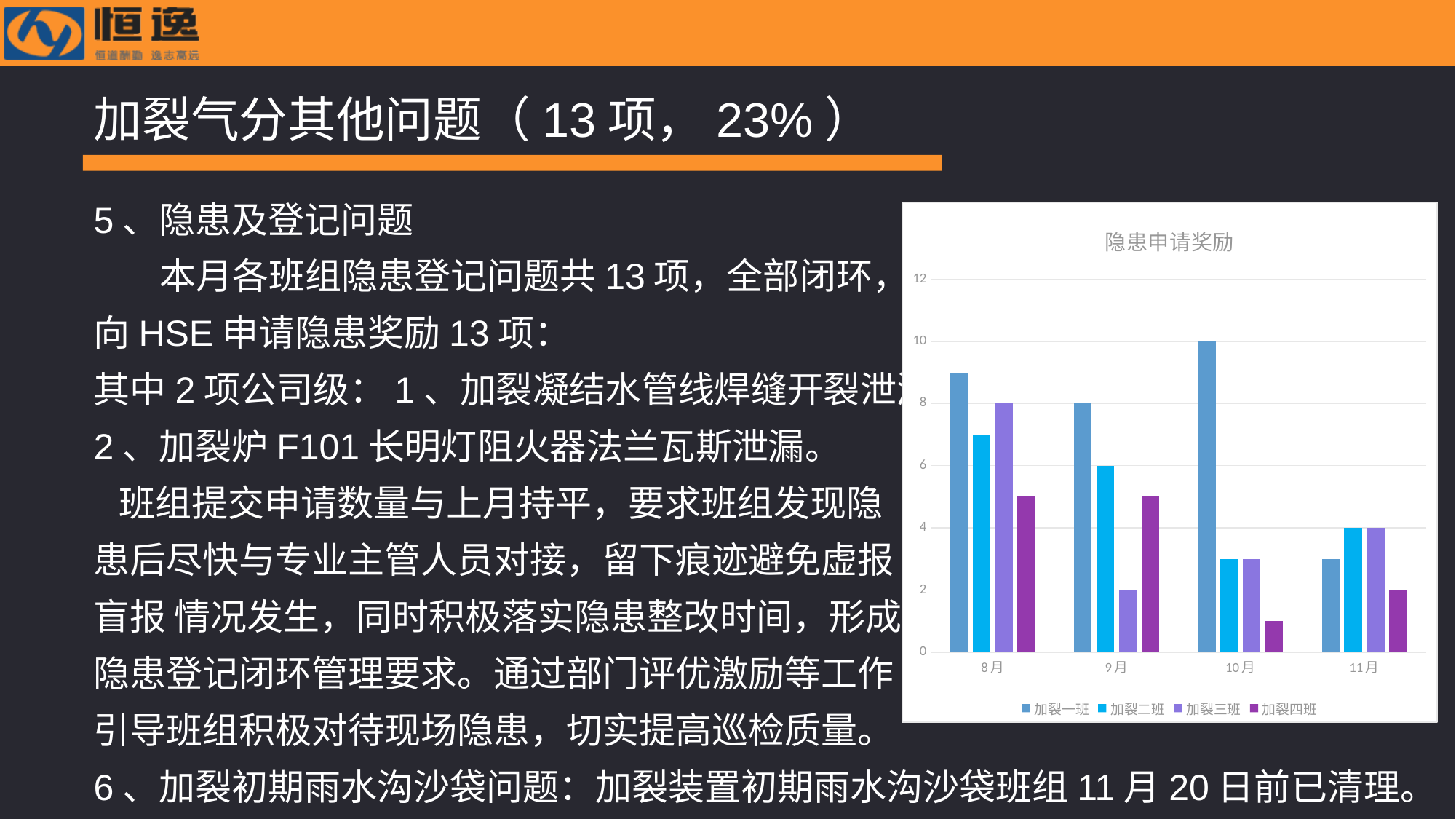
How many month categories are shown on the x axis of the chart? 4 What is the value for 加裂二班 in 11月? 4 What is the title of the chart? 隐患申请奖励 What is the value for 加裂三班 in 9月? 2 Which series has the highest bar in 10月? 加裂一班 Is the value for 加裂四班 in 10月 greater or less than 2? less What kind of chart is shown on the slide? bar chart What is the value for 加裂一班 in 10月? 10 Which series has the lowest bar in 10月? 加裂四班 What is the difference between 加裂一班 and 加裂二班 in 9月? 2 Is the value for 加裂二班 in 8月 greater or less than 6? greater How many series does the chart legend list? 4